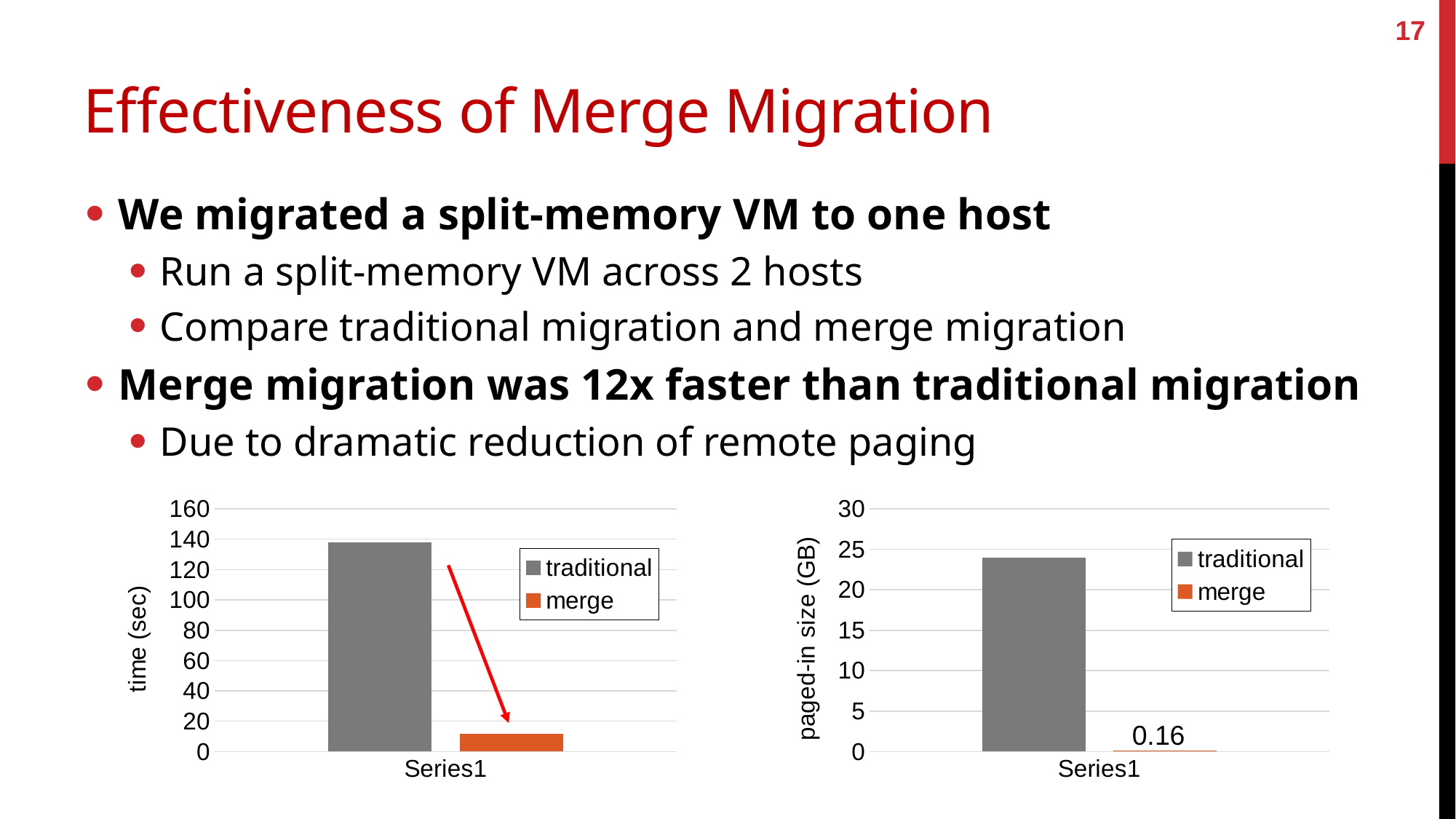
In the left chart (time (sec)), is the value for traditional greater or less than 120? greater How many series does the legend of the left chart (time (sec)) list? 2 What is the y-axis label of the right chart? paged-in size (GB) In the right chart (paged-in size (GB)), is the value for traditional greater or less than 25? less In the left chart (time (sec)), is the value for merge greater or less than 20? less In the right chart (paged-in size (GB)), which series has the lowest value? merge What type of chart is the left chart (time (sec))? bar chart In the right chart (paged-in size (GB)), what is the value for merge? 0.16 In the left chart, what colour is the bar for merge? orange In the left chart (time (sec)), which series has the taller bar, traditional or merge? traditional